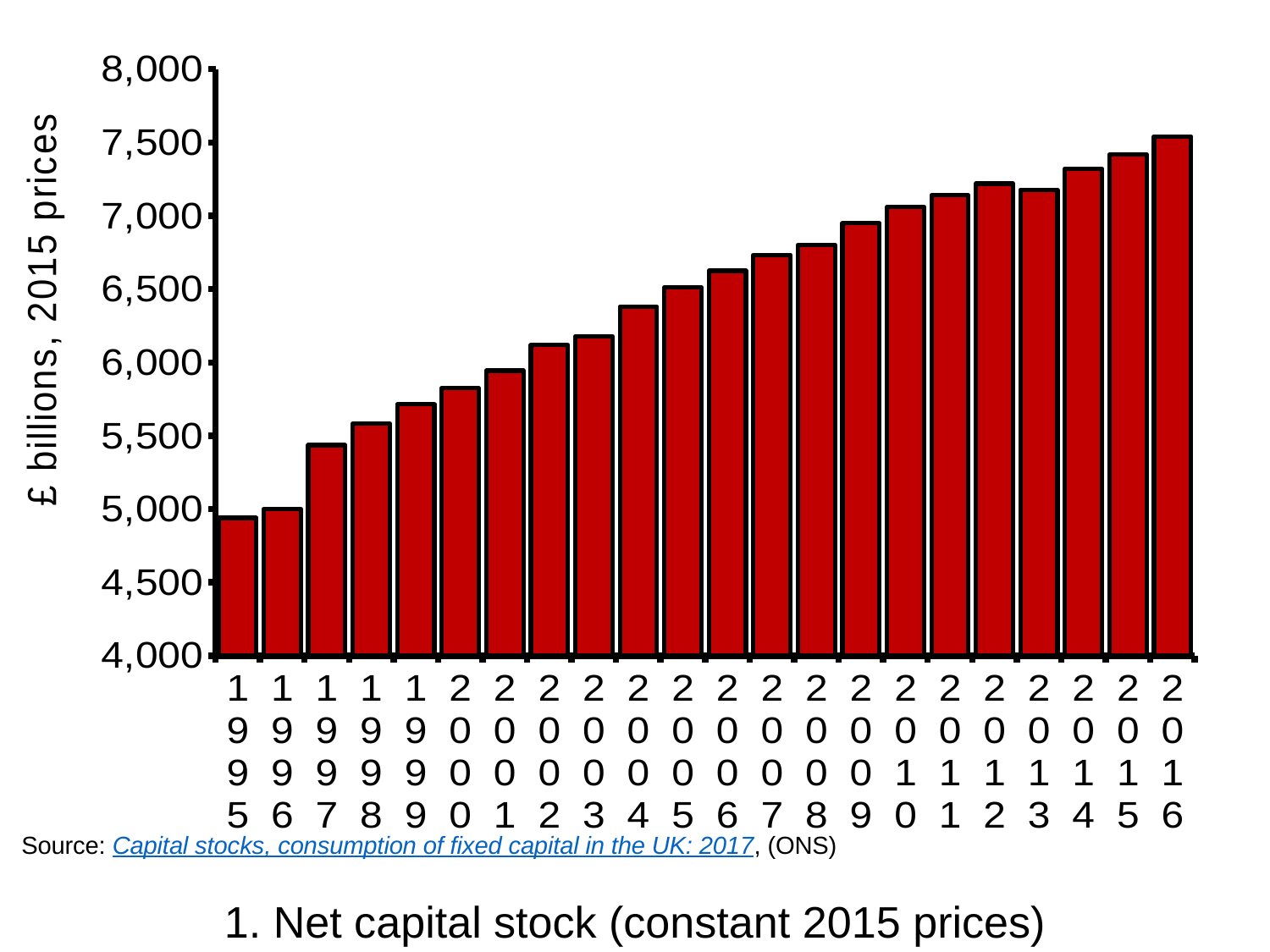
Which year has the larger value, 2013 or 2014? 2014 Is the value for 2013 greater or less than 7,500? less What is the title of the chart? 1. Net capital stock (constant 2015 prices) Which year has the lowest net capital stock in the chart? 1995 Is the value for 2000 greater or less than 5,500? greater Is the value for 2008 greater or less than 6,500? greater What kind of chart is shown on the slide? bar chart What is the label on the vertical axis? £ billions, 2015 prices Do the values generally rise or fall from 1995 to 2016? rise How many years (bars) are plotted in the chart? 22 Which year has the highest net capital stock in the chart? 2016